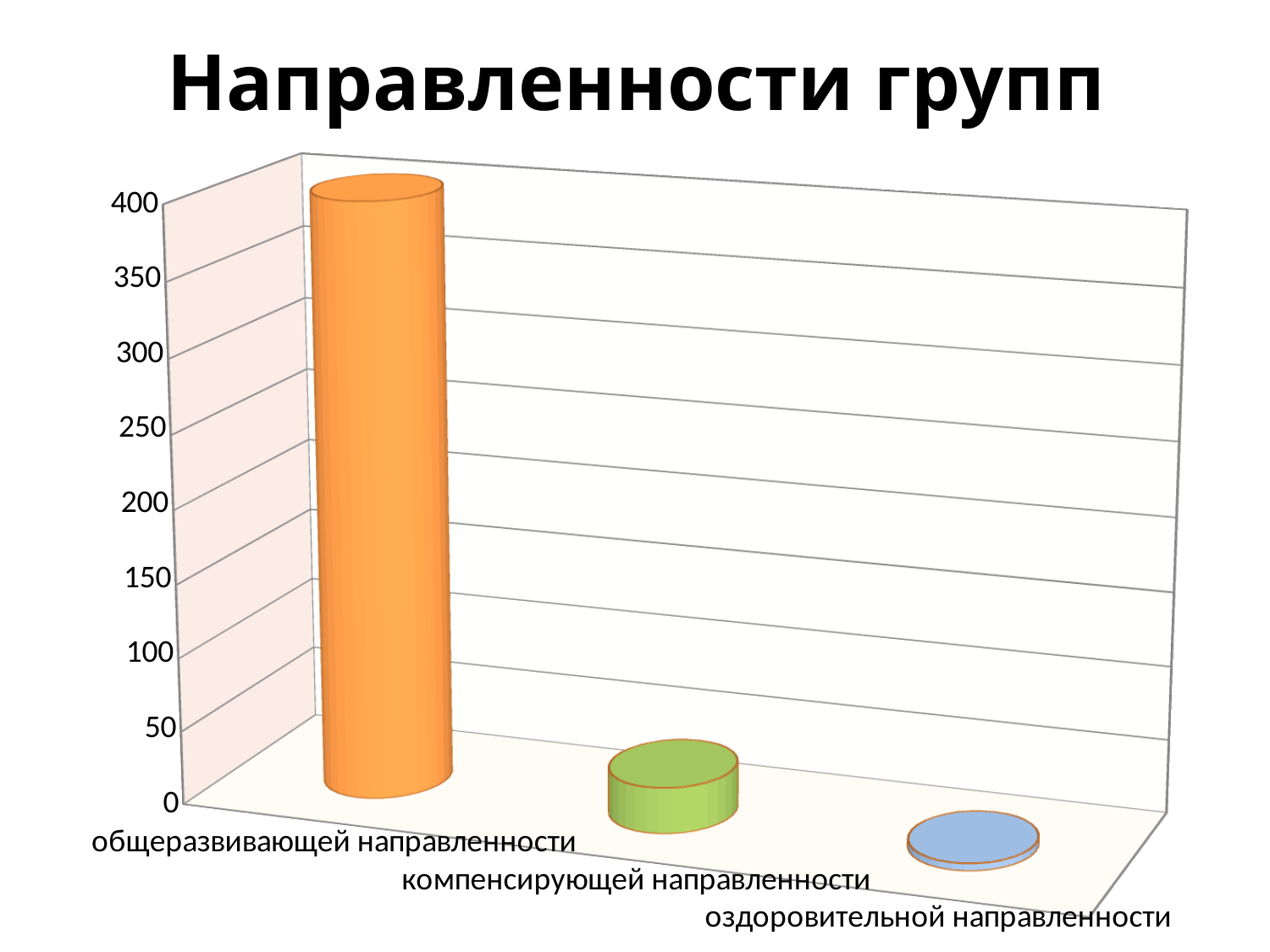
What is the title of the slide? Направленности групп What kind of chart is shown on the slide? bar chart Which category has the lowest value? оздоровительной направленности Which is larger, the value for общеразвивающей направленности or the value for компенсирующей направленности? общеразвивающей направленности Which category has the highest value? общеразвивающей направленности Is the value for общеразвивающей направленности greater or less than 300? greater How many categories are shown in the chart? 3 What is the highest value shown on the vertical axis? 400 What colour is the bar for общеразвивающей направленности? orange Is the value for оздоровительной направленности greater or less than 50? less Which is larger, the value for компенсирующей направленности or the value for оздоровительной направленности? компенсирующей направленности Is the value for компенсирующей направленности greater or less than 100? less